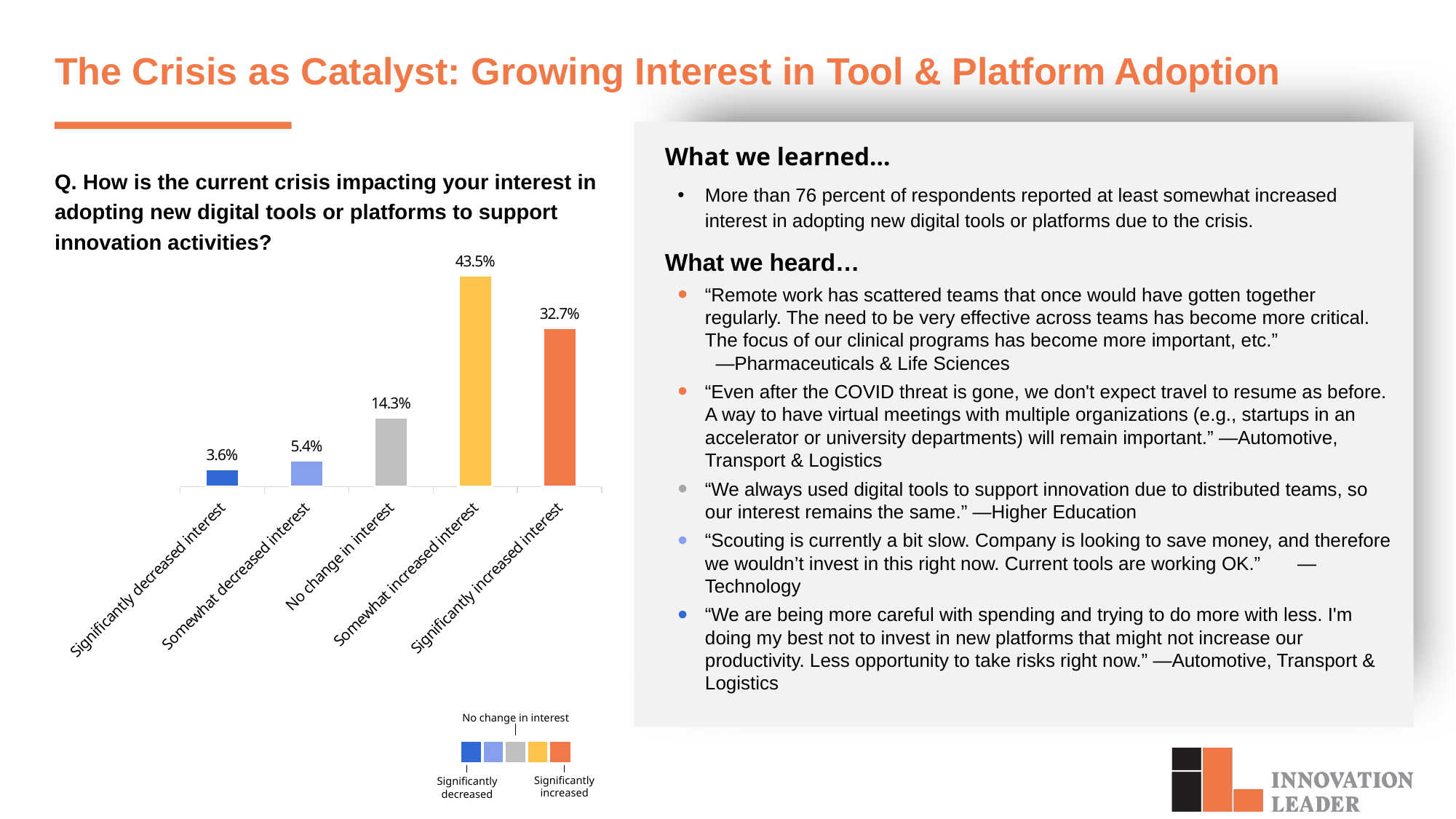
How many response categories are shown in the chart? 5 What is the difference between the percentages for somewhat increased interest and significantly increased interest? 10.8% Which response category has the lowest percentage? Significantly decreased interest Which is larger: the percentage for somewhat decreased interest or for no change in interest? No change in interest What percentage of respondents reported somewhat increased interest? 43.5% Which response category has the highest percentage? Somewhat increased interest What percentage of respondents reported significantly increased interest? 32.7% What percentage of respondents reported significantly decreased interest? 3.6% What kind of chart is used to show the responses? Bar chart What is the combined percentage of respondents reporting somewhat decreased and significantly decreased interest? 9.0% What percentage of respondents reported no change in interest? 14.3% What colour is the bar for somewhat increased interest? Yellow